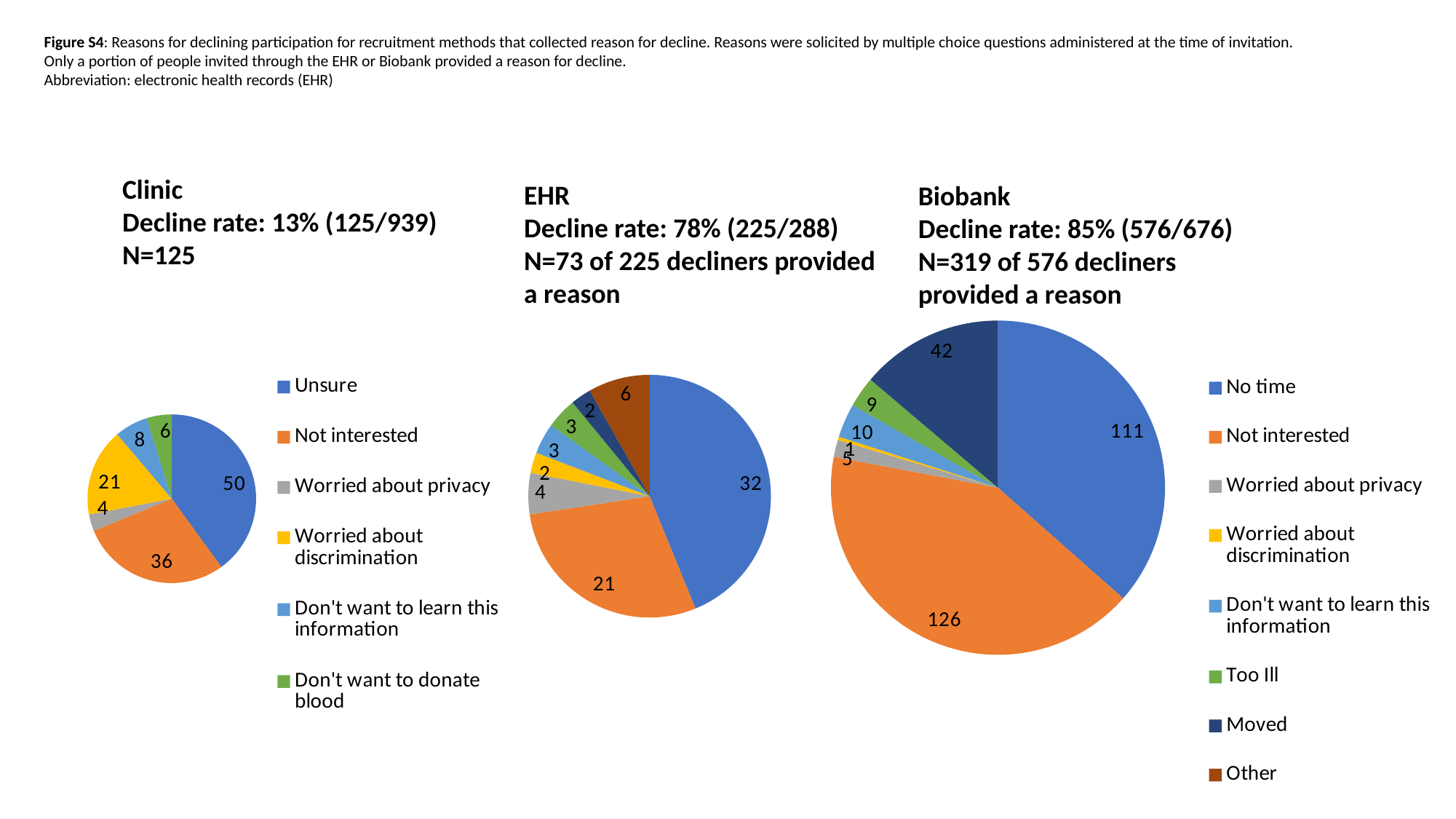
In the Biobank pie chart, what is the value for Not interested? 126 In the Biobank pie chart, what is the value for No time? 111 In the Clinic pie chart, what is the value for Not interested? 36 In the Clinic pie chart, what is the value for Worried about discrimination? 21 How many entries does the legend to the right of the Biobank pie chart list? 8 In the EHR pie chart, how many slices are there? 8 In the Clinic pie chart, how many slices are there? 6 What kind of charts are shown on the slide? Pie charts In the EHR pie chart, what is the value for Not interested? 21 In the Clinic pie chart, what is the difference between the Not interested slice and the Worried about privacy slice? 32 In the Biobank pie chart, which is larger, Not interested or No time? Not interested In the EHR pie chart, what is the value for Worried about privacy? 4